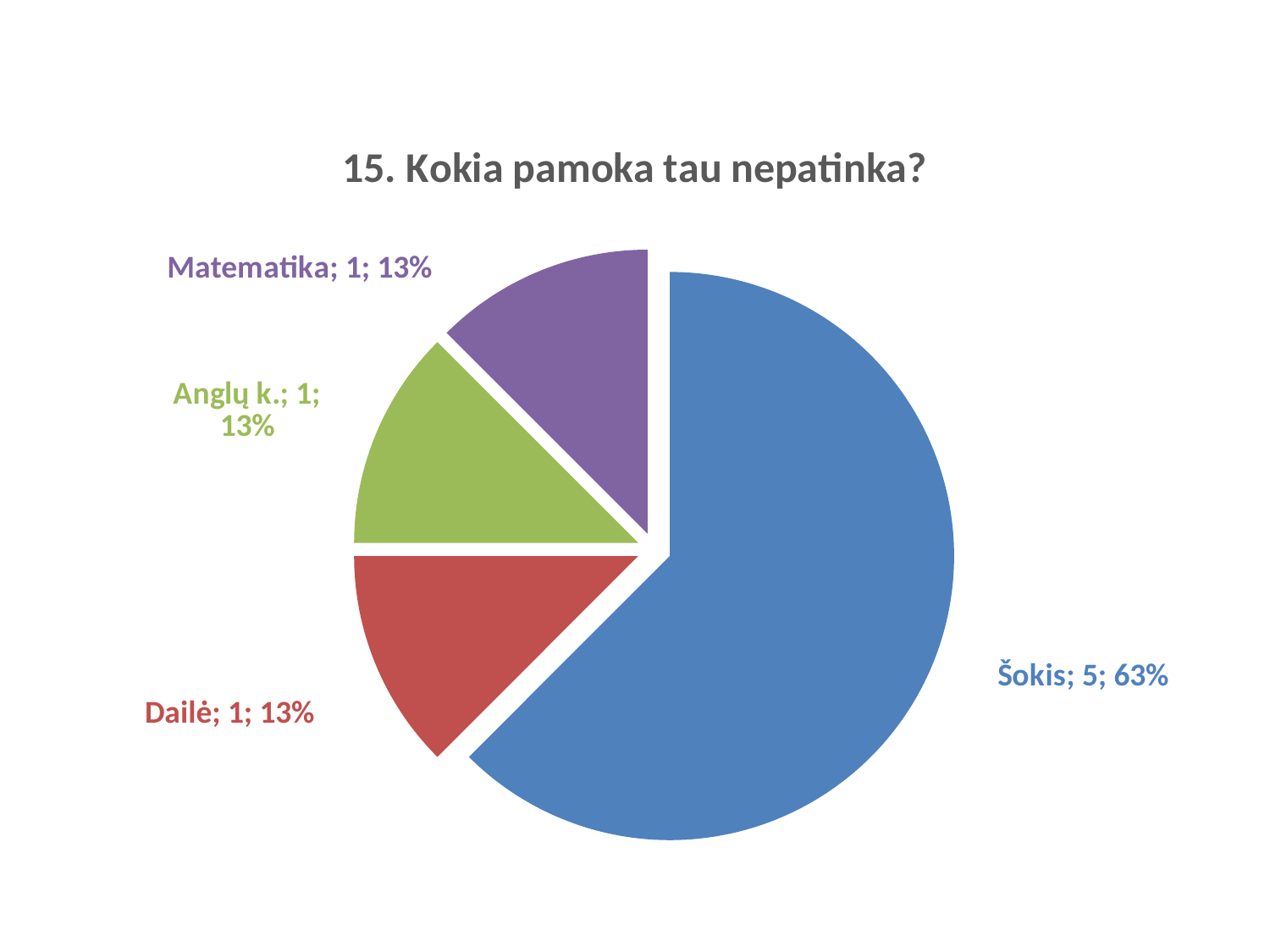
What is the title of the chart? 15. Kokia pamoka tau nepatinka? How many slices does the pie chart have? 4 Which category has the largest slice? Šokis What colour is the Šokis slice? blue What share of the pie does Šokis represent? 63% What is the total of all the values shown in the pie chart? 8 What kind of chart is shown on the slide? pie chart What is the value for Šokis? 5 What is the value for Dailė? 1 What share of the pie does Matematika represent? 13% What is the difference between the values for Šokis and Anglų k.? 4 Which is larger, the value for Šokis or the value for Dailė? Šokis